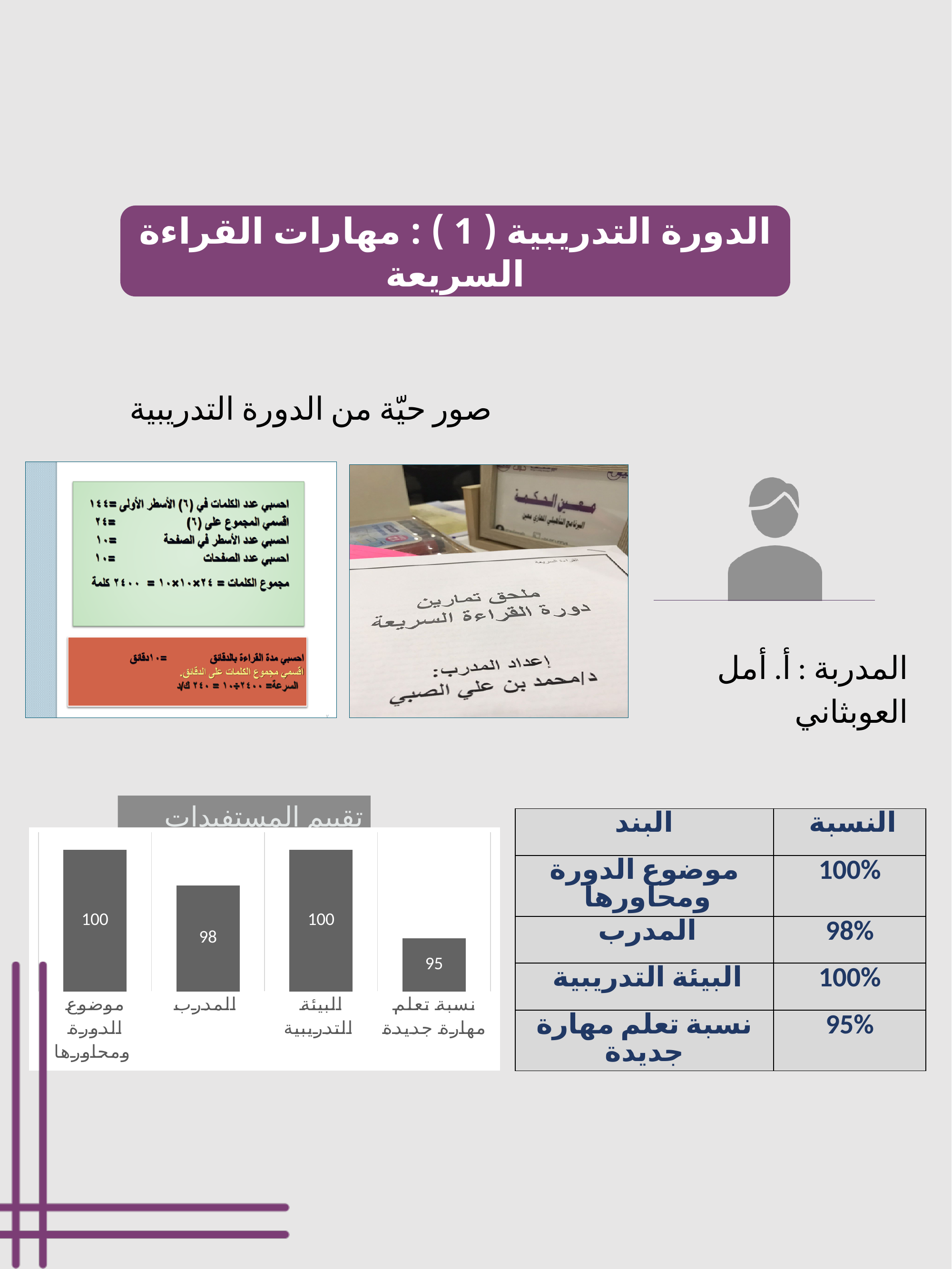
What is the value of the bar for موضوع الدورة ومحاورها in the bar chart? 100 Which is larger in the bar chart: the value for المدرب or the value for نسبة تعلم مهارة جديدة? المدرب What is the value of the bar for المدرب in the bar chart? 98 How many categories are shown in the bar chart? 4 What is the difference between the values for المدرب and نسبة تعلم مهارة جديدة in the bar chart? 3 Which is larger in the bar chart: the value for البيئة التدريبية or the value for المدرب? البيئة التدريبية What is the title of the bar chart? تقيم المستفيدات What is the difference between the values for البيئة التدريبية and المدرب in the bar chart? 2 What kind of chart is shown at the bottom left of the slide? Bar chart Which category has the lowest value in the bar chart? نسبة تعلم مهارة جديدة What is the value of the bar for البيئة التدريبية in the bar chart? 100 What is the value of the bar for نسبة تعلم مهارة جديدة in the bar chart? 95